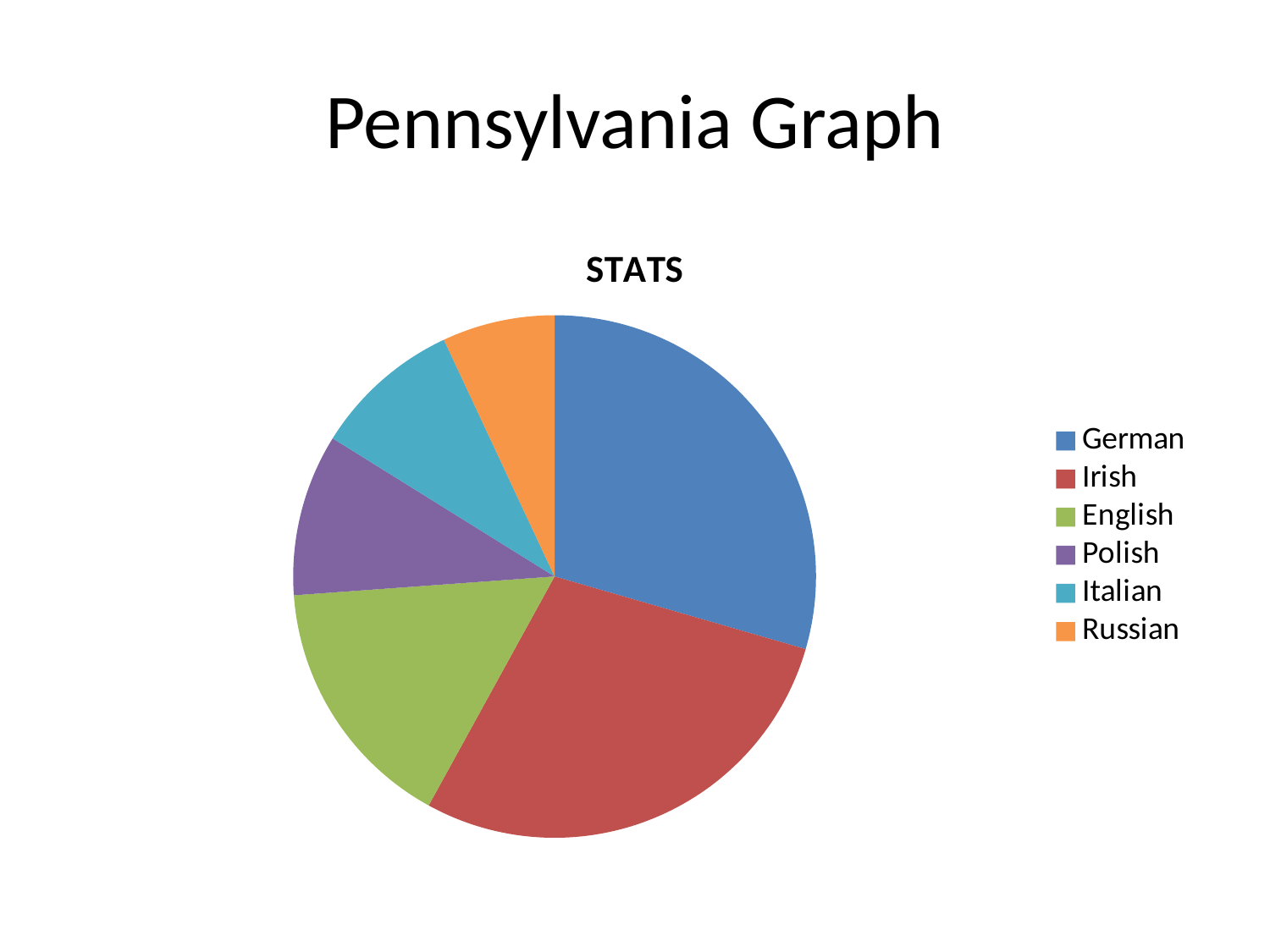
What kind of chart is shown on the slide? pie chart How many entries does the legend list? 6 How many categories does the pie chart show? 6 Which slice is larger, German or Russian? German Which category has the smallest slice of the pie? Russian Which slice is larger, Irish or Polish? Irish Which slice is larger, Irish or English? Irish What is the title of the chart? STATS What colour is the German slice? blue